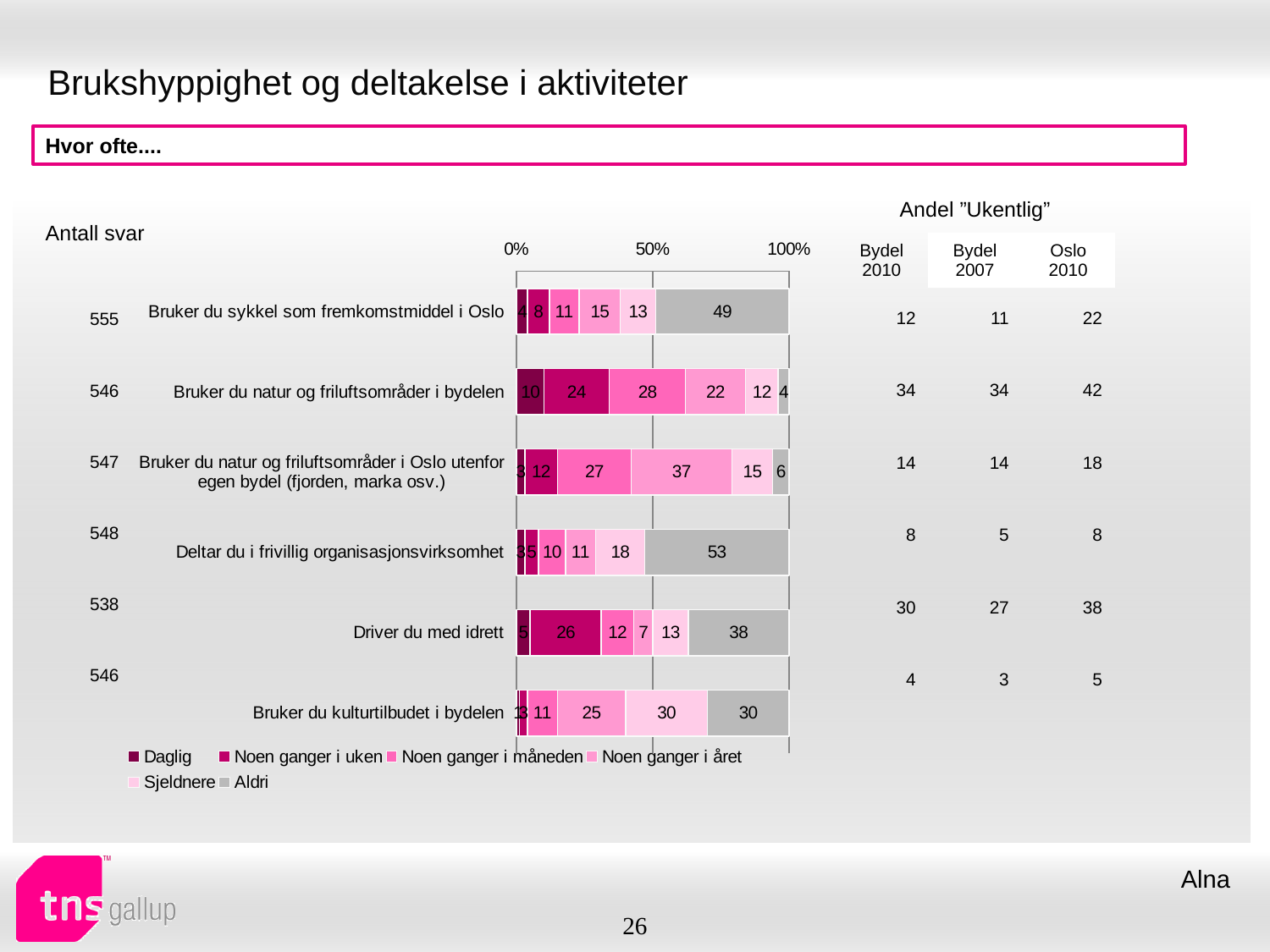
What percentage answered "Aldri" for "Deltar du i frivillig organisasjonsvirksomhet"? 53 How many series does the legend list? 6 What kind of chart is shown on the slide? Stacked bar chart Which activity has the highest "Aldri" share? Deltar du i frivillig organisasjonsvirksomhet What is the difference between the "Aldri" values for "Bruker du sykkel som fremkomstmiddel i Oslo" and "Driver du med idrett"? 11 Which activity has the lowest "Aldri" share? Bruker du natur og friluftsområder i bydelen What is the "Noen ganger i året" value for "Bruker du natur og friluftsområder i Oslo utenfor egen bydel (fjorden, marka osv.)"? 37 What is the "Noen ganger i uken" value for "Driver du med idrett"? 26 What is the first entry in the chart legend? Daglig What percentage answered "Aldri" for "Bruker du sykkel som fremkomstmiddel i Oslo"? 49 How many activities (categories) are shown in the chart? 6 Which has a larger "Aldri" share: "Bruker du sykkel som fremkomstmiddel i Oslo" or "Driver du med idrett"? Bruker du sykkel som fremkomstmiddel i Oslo